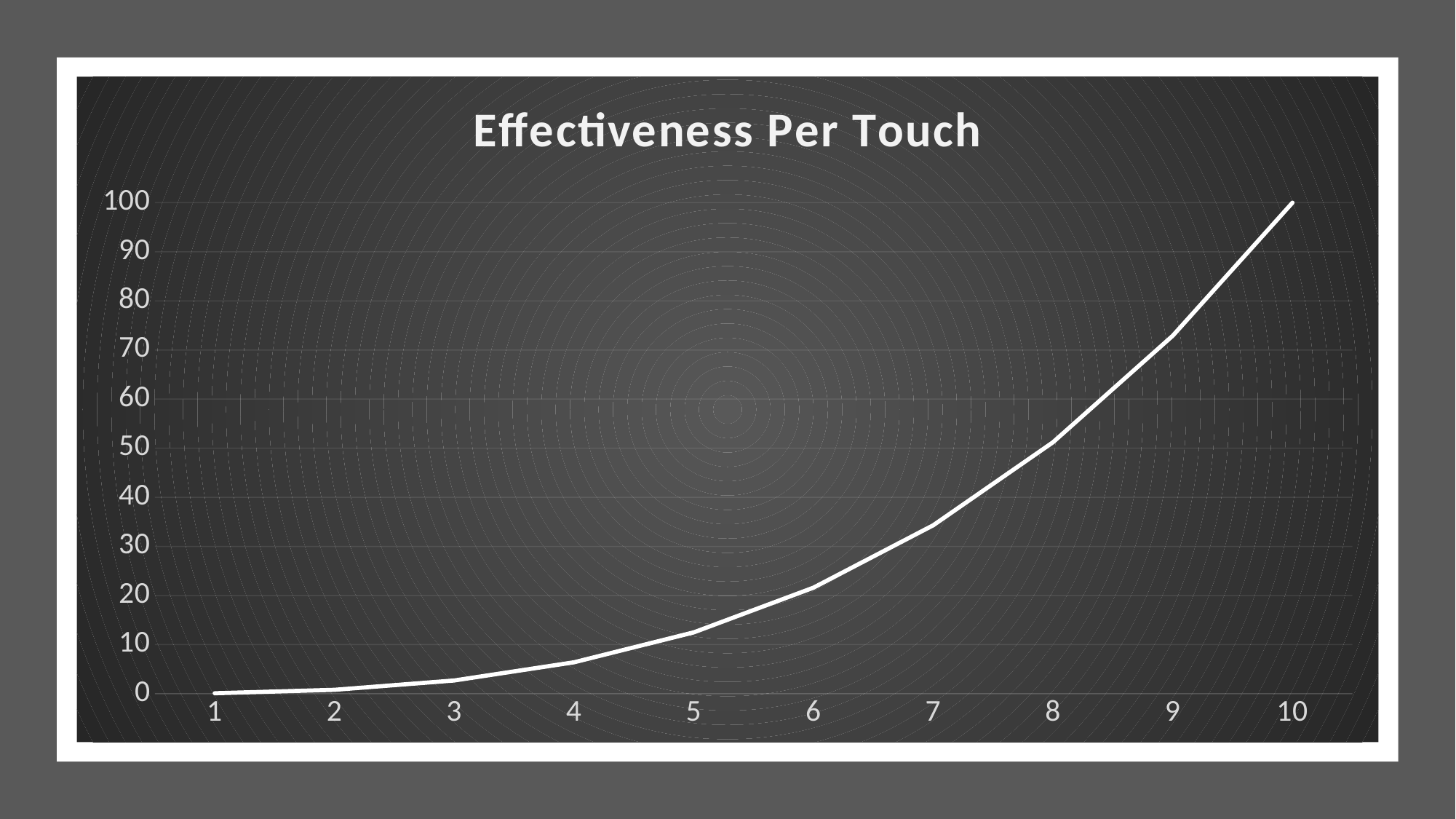
Which has the larger value, x = 9 or x = 5? 9 Is the value at x = 4 greater or less than 10? less At which x-axis point is the value lowest? 1 What is the title of the chart? Effectiveness Per Touch Do the values rise or fall as the x axis goes from 1 to 10? rise Is the value at x = 5 greater or less than 10? greater At which x-axis point is the value highest? 10 Is the value at x = 9 greater or less than 60? greater What is the value at x = 10? 100 How many points are plotted along the x axis? 10 What kind of chart is shown on the slide? line chart